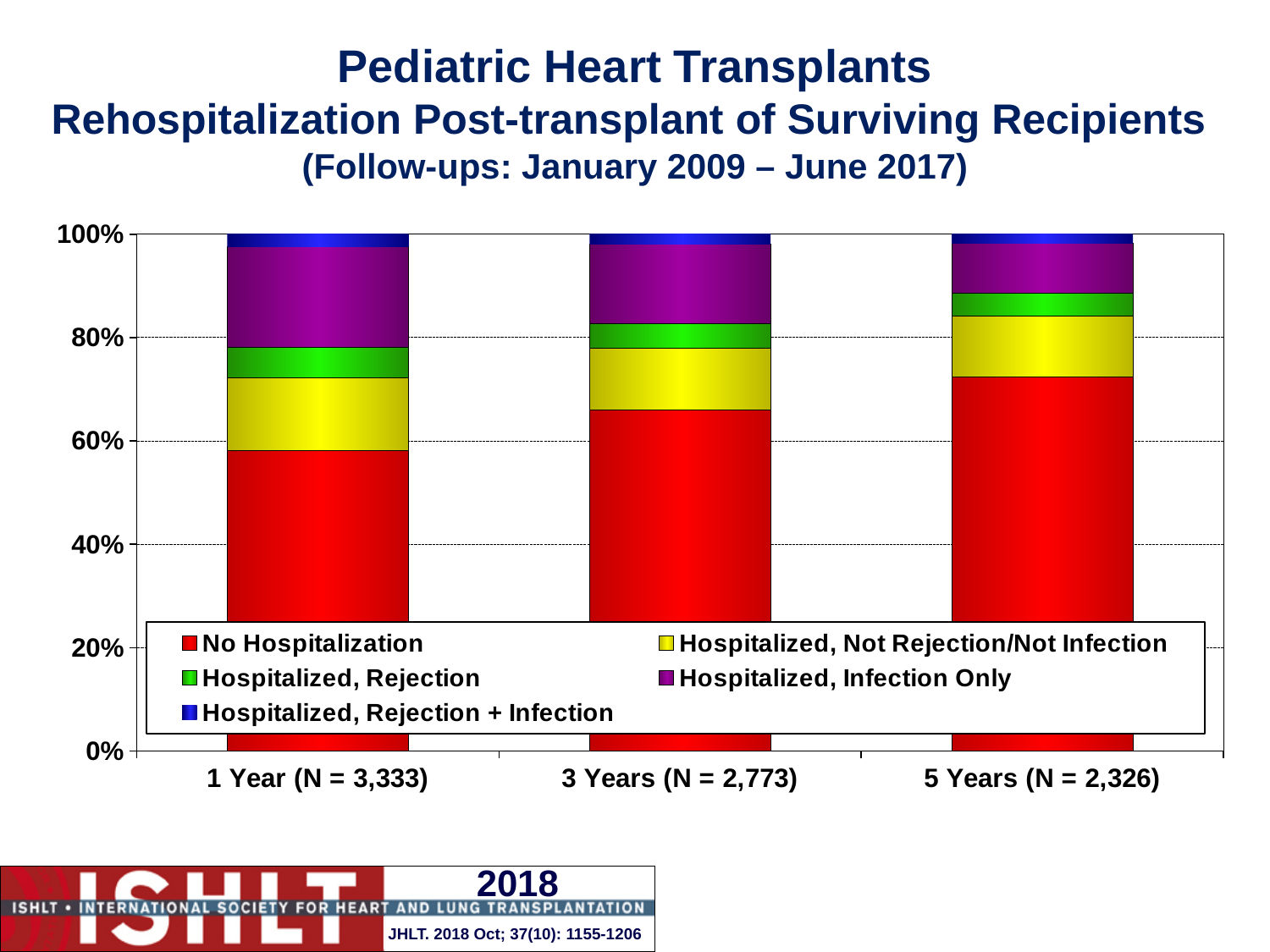
Which is larger, the No Hospitalization share at 1 Year or at 5 Years? 5 Years Is the No Hospitalization share at 3 Years greater or less than 60%? greater Is the No Hospitalization share at 5 Years greater or less than 80%? less Does the No Hospitalization share rise or fall from 1 Year to 5 Years? rise Which colour represents No Hospitalization in the legend? Red How many follow-up time categories are shown on the x axis? 3 At which follow-up time is the No Hospitalization share the highest? 5 Years (N = 2,326) At which follow-up time is the No Hospitalization share the lowest? 1 Year (N = 3,333) What kind of chart is shown on the slide? Stacked bar chart Is the No Hospitalization share at 1 Year greater or less than 60%? less How many series does the legend list? 5 What is the total of the stacked bar for 3 Years? 100%